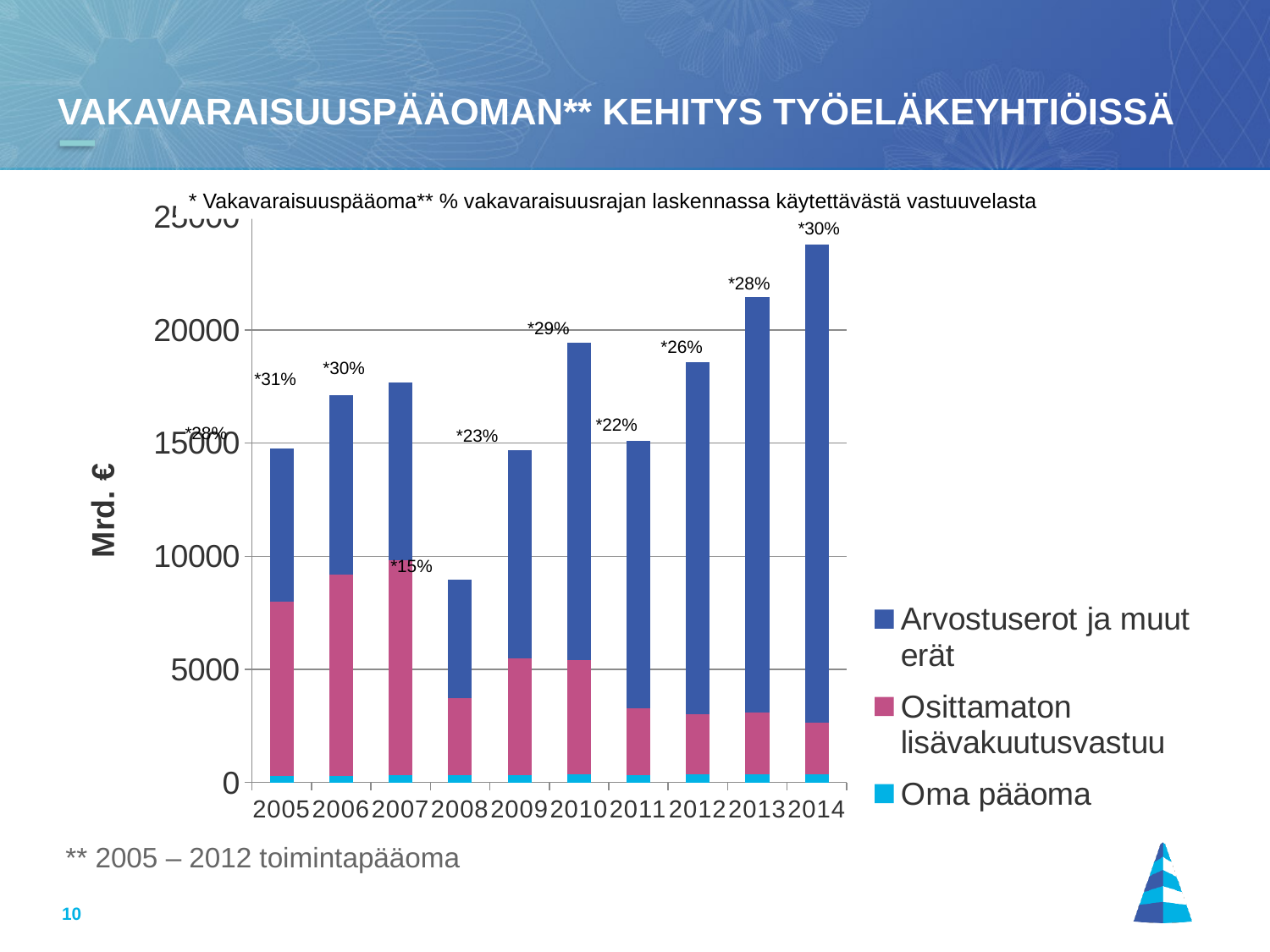
What is the label on the chart's vertical axis? Mrd. € What kind of chart is shown on the slide? Stacked bar chart Which year has the shortest stacked bar? 2008 Which year has the larger total bar, 2012 or 2013? 2013 Do the total bars rise or fall from 2011 to 2014? Rise Is the total bar for 2008 greater or less than 10000? less Is the total bar for 2014 greater or less than 20000? greater How many series does the chart's legend list? 3 How many years are shown on the x axis of the chart? 10 Which year has the tallest stacked bar? 2014 Is the total bar for 2010 greater or less than 20000? less What percentage label is shown above the 2014 bar? *30%